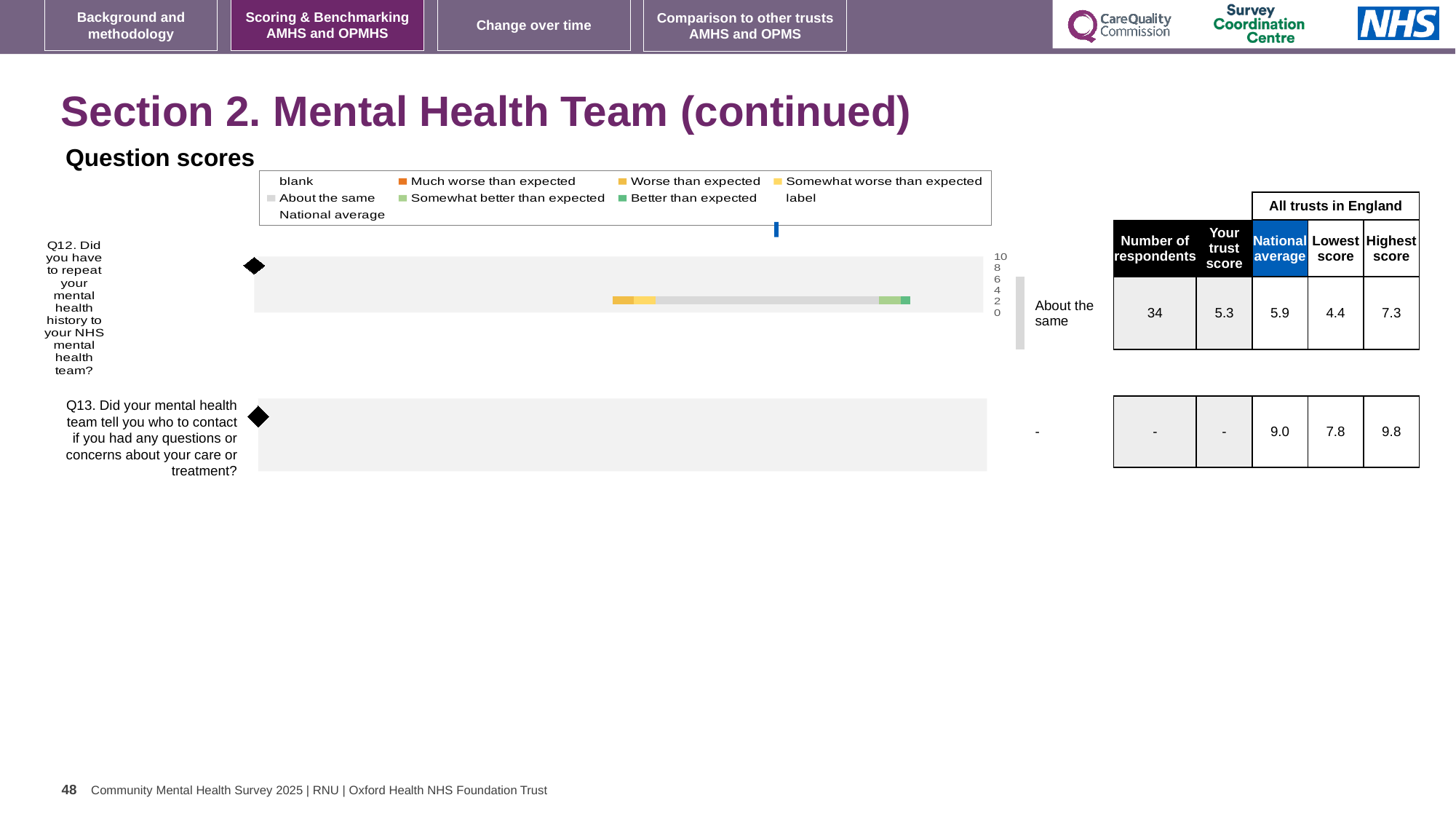
What is the trust score for Q12 (repeating mental health history)? 5.3 What is the national average score for Q12? 5.9 How many questions are plotted in the question scores chart? 2 What benchmark category is shown next to the bar for Q12? About the same What is the difference between the national average and the trust score for Q12? 0.6 How many respondents answered Q12? 34 What kind of chart is used to show the question scores on this slide? bar chart What is the highest tick value shown on the chart's score axis? 10 What is the highest score among all trusts in England for Q13? 9.8 For Q12, which is larger: the trust score or the national average? national average What is the difference between the highest score and the lowest score for Q12? 2.9 How many entries does the legend of the question scores chart list? 9